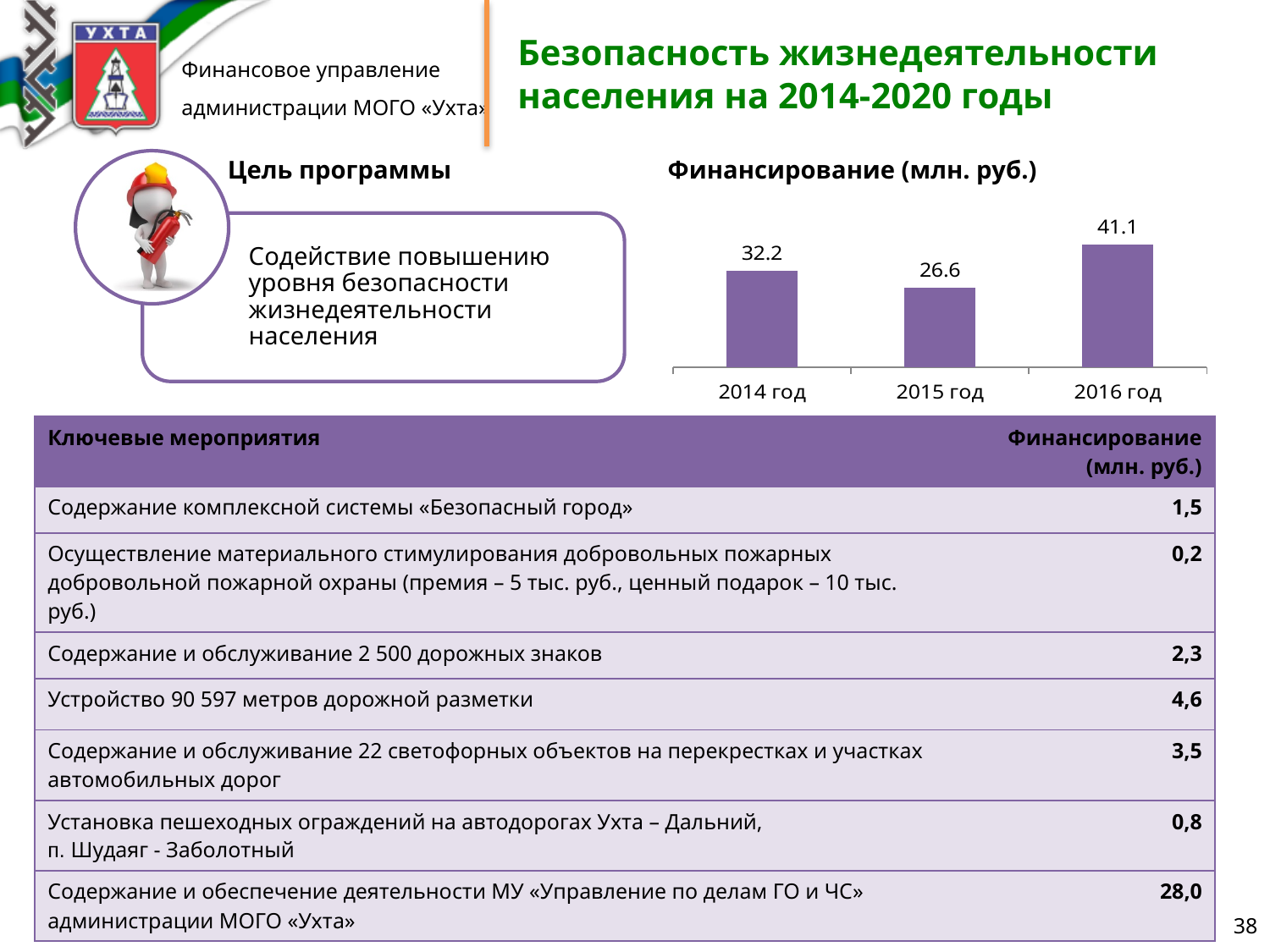
How many years are shown in the chart? 3 Which year has the highest funding in the chart? 2016 год Does the funding rise or fall from 2015 год to 2016 год? rise Which year has the lowest funding in the chart? 2015 год Which is larger, the funding for 2014 год or for 2016 год? 2016 год What is the difference between the funding for 2016 год and 2015 год? 14.5 What is the title of the chart? Финансирование (млн. руб.) What is the difference between the funding for 2014 год and 2015 год? 5.6 What is the funding value shown for 2016 год? 41.1 What type of chart is used to show the funding? bar chart What is the funding value shown for 2014 год? 32.2 What is the funding value shown for 2015 год? 26.6